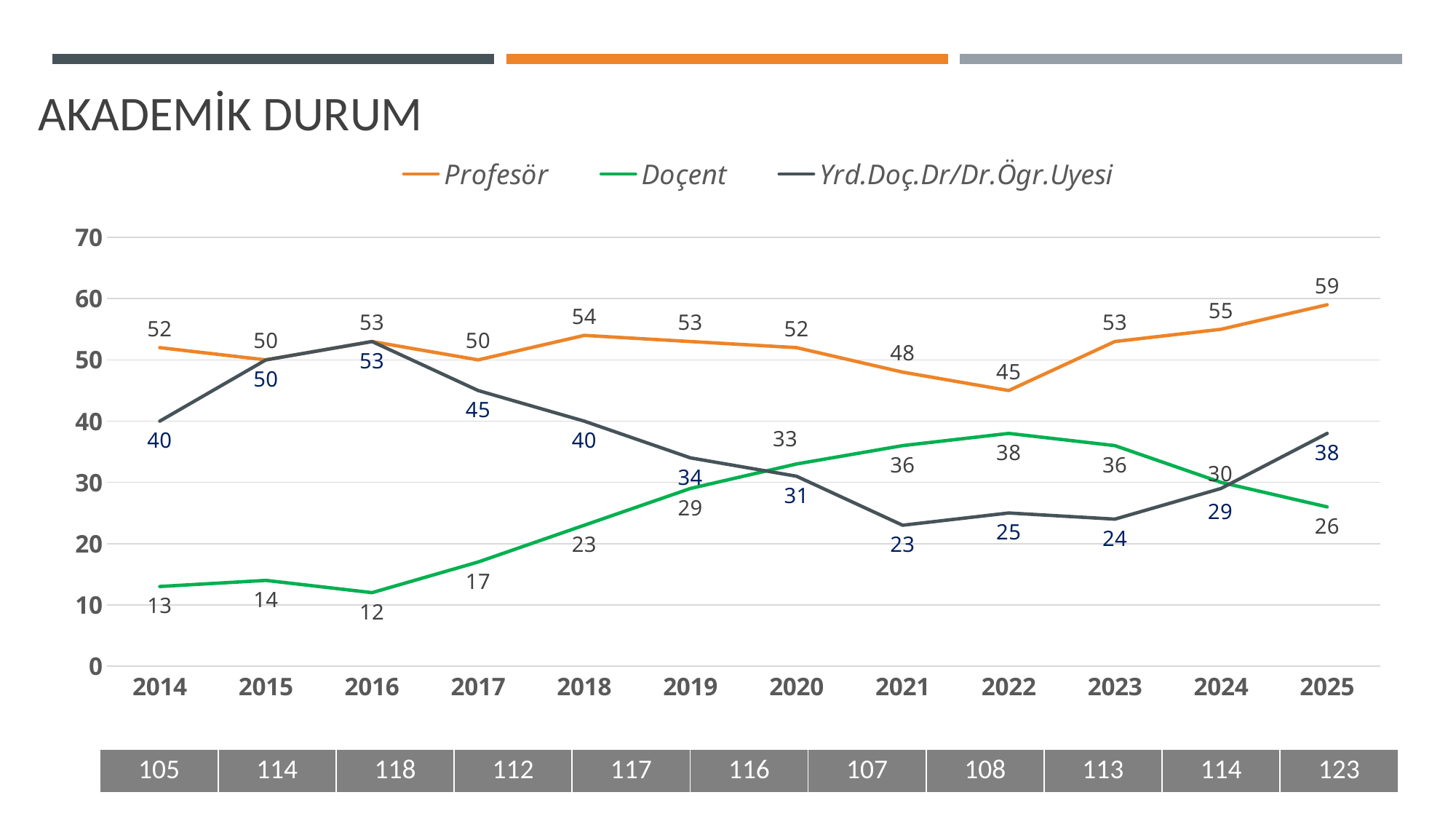
Does the Doçent series rise or fall from 2014 to 2022? rise What is the value for Profesör in 2025? 59 What is the difference between the Profesör values in 2025 and 2022? 14 In which year is the Doçent series at its lowest? 2016 In 2021, which is larger: Doçent or Yrd.Doç.Dr/Dr.Ögr.Uyesi? Doçent What is the value for Yrd.Doç.Dr/Dr.Ögr.Uyesi in 2016? 53 What is the value for Doçent in 2022? 38 How many series does the legend list? 3 How many years are plotted along the x axis? 12 In which year is the Profesör series at its highest? 2025 What colour is the Profesör line in the legend? orange What kind of chart is shown on the slide? line chart